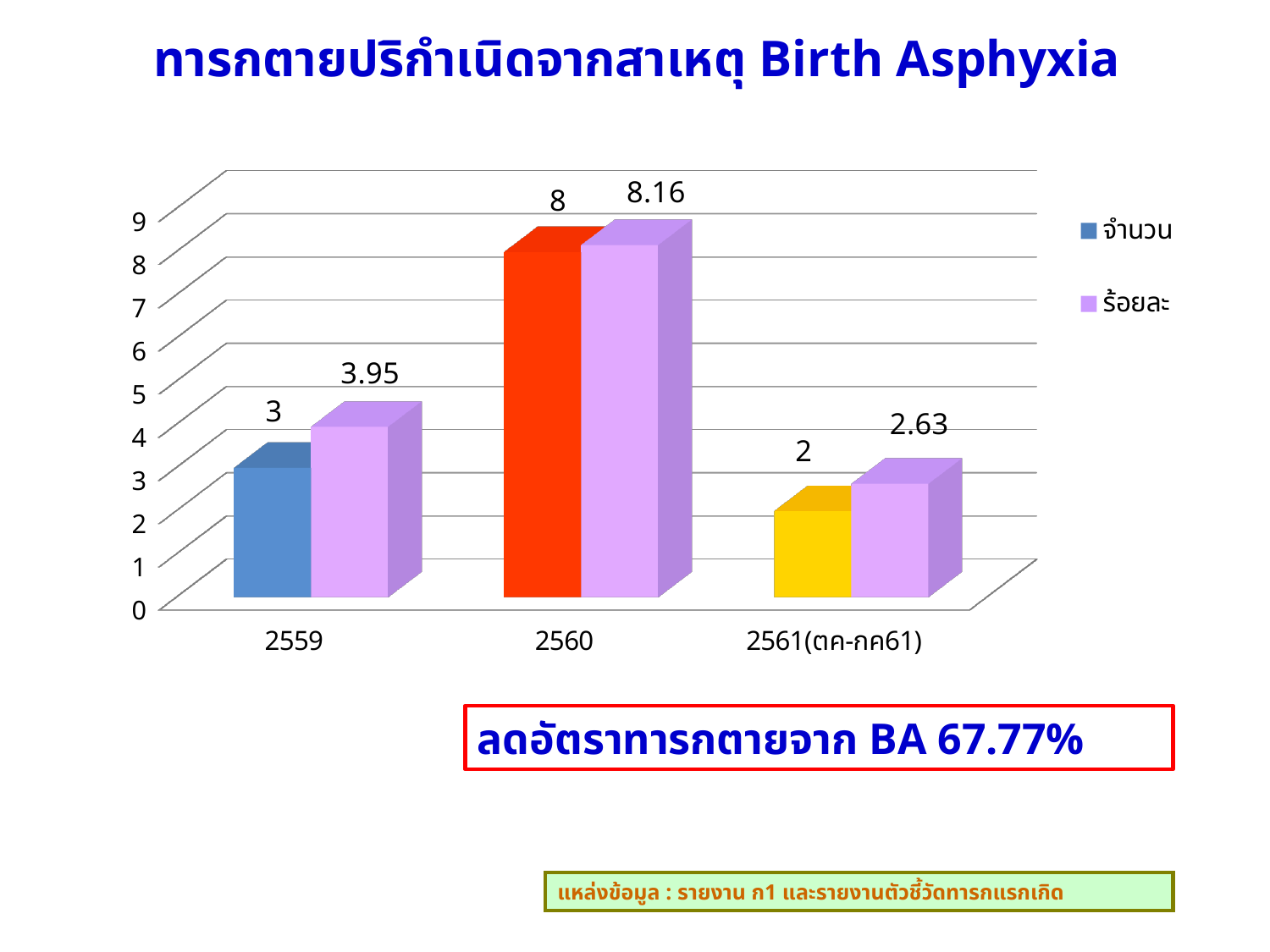
What is the ร้อยละ value for 2559? 3.95 Which category has the lowest จำนวน value? 2561(ตค-กค61) What is the difference between the จำนวน values for 2560 and 2559? 5 What is the จำนวน value for 2561(ตค-กค61)? 2 What is the จำนวน value for 2560? 8 How many series does the legend list? 2 How many categories are shown on the x axis? 3 What is the ร้อยละ value for 2561(ตค-กค61)? 2.63 What is the difference between the ร้อยละ values for 2560 and 2561(ตค-กค61)? 5.53 Which category has the highest ร้อยละ value? 2560 What kind of chart is shown on the slide? bar chart Which is larger, the ร้อยละ value for 2559 or for 2561(ตค-กค61)? 2559